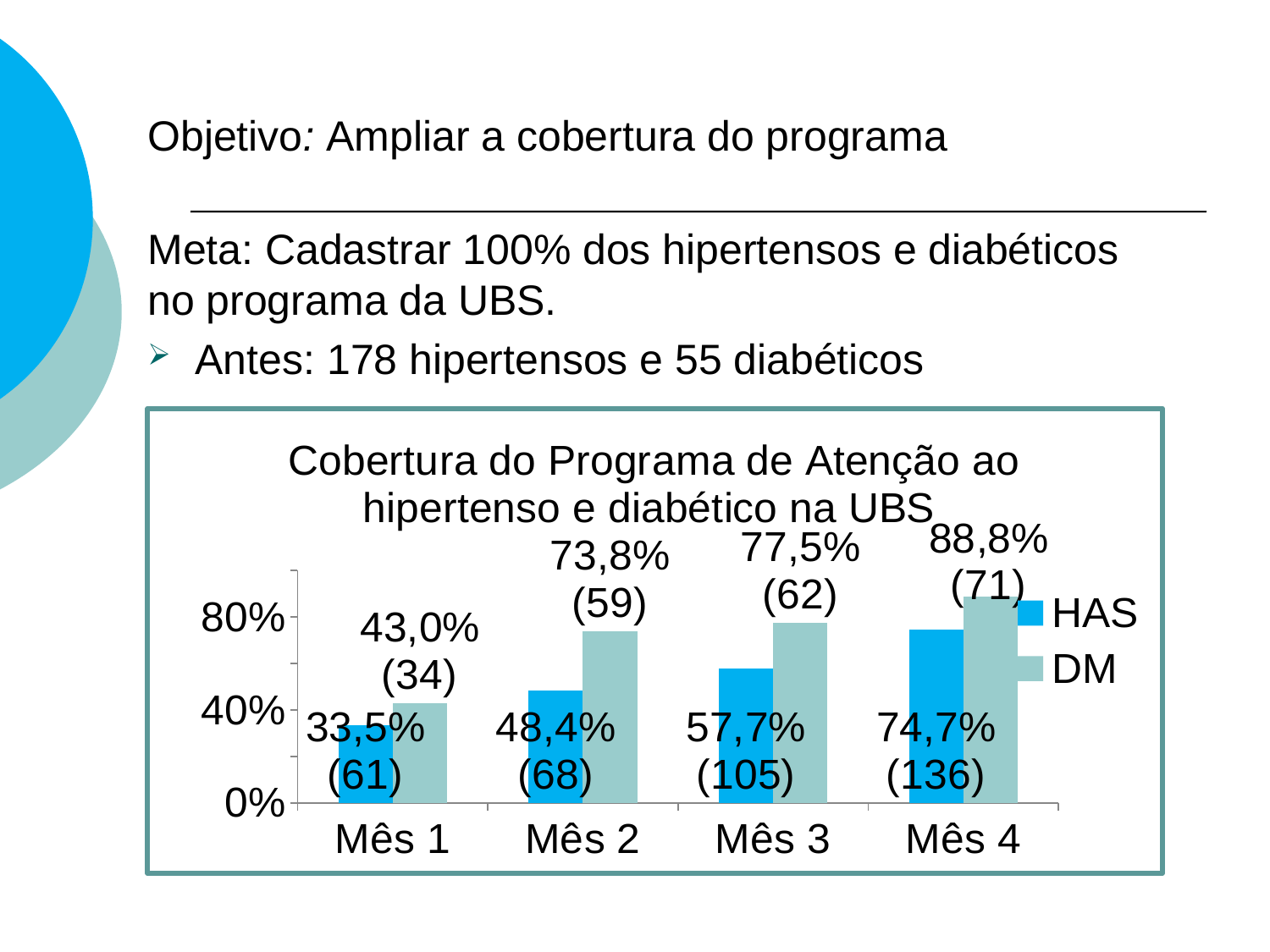
How many months are shown on the x axis? 4 What kind of chart is shown on the slide? Bar chart What is the DM value for Mês 2? 73,8% What is the DM value for Mês 4? 88,8% In which month is the HAS value highest? Mês 4 What is the difference between the DM and HAS percentages in Mês 2? 25,4% Which is larger in Mês 3, the HAS value or the DM value? DM What is the HAS value for Mês 3? 57,7% What is the HAS value for Mês 1? 33,5% How many series does the legend list? 2 In which month is the DM value lowest? Mês 1 Do the HAS values rise or fall from Mês 1 to Mês 4? Rise